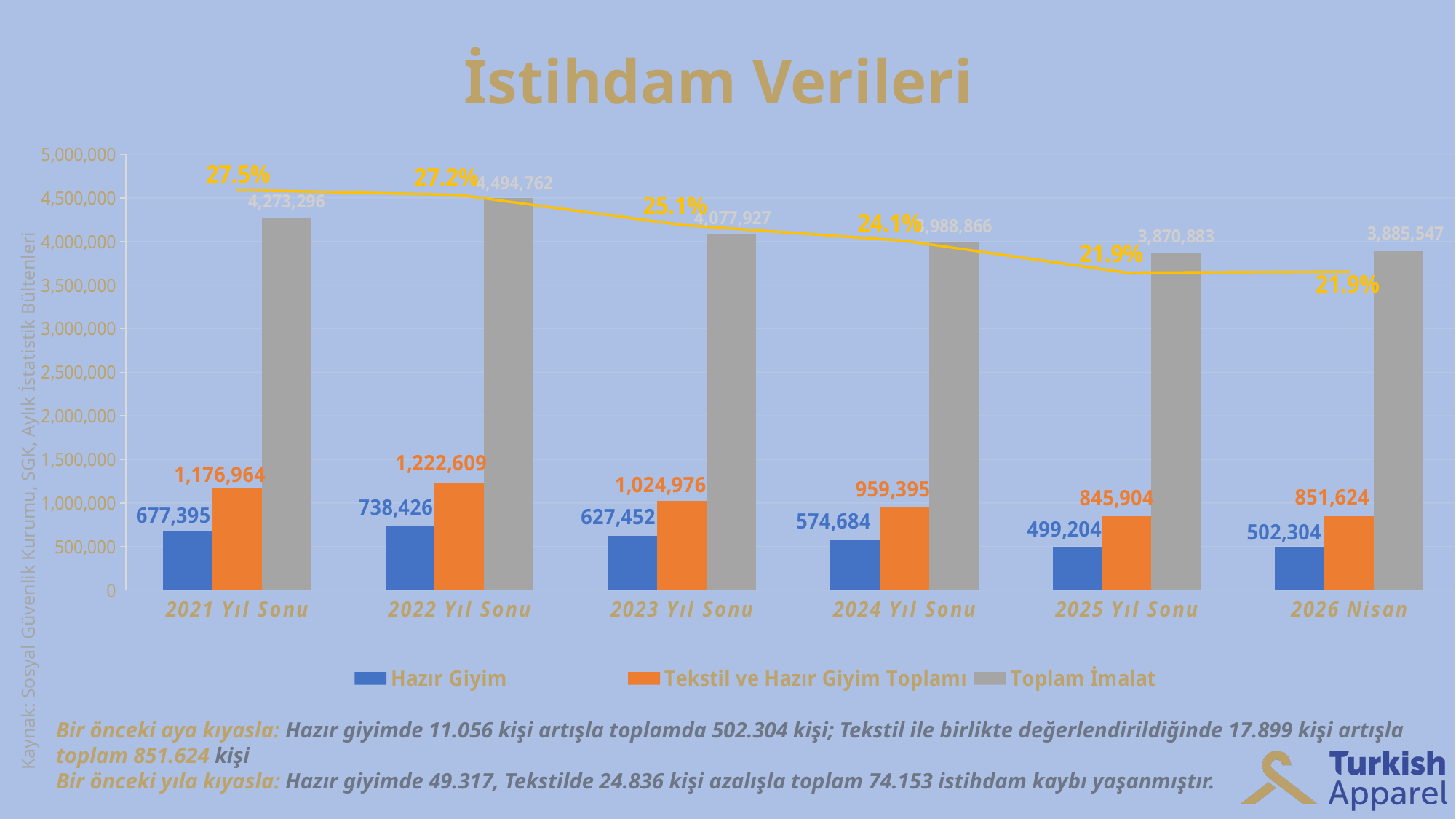
What is the value for Tekstil ve Hazır Giyim Toplamı at 2026 Nisan? 851,624 In which period is Hazır Giyim lowest? 2025 Yıl Sonu Which is larger for Hazır Giyim: 2023 Yıl Sonu or 2024 Yıl Sonu? 2023 Yıl Sonu Is the value for Toplam İmalat at 2025 Yıl Sonu greater or less than 4,000,000? less In which period is Toplam İmalat highest? 2022 Yıl Sonu How many series does the legend list? 3 What kind of chart is this? combination bar and line chart How many periods are shown on the x axis? 6 What is the difference between Tekstil ve Hazır Giyim Toplamı at 2022 Yıl Sonu and at 2021 Yıl Sonu? 45,645 What is the value for Toplam İmalat at 2023 Yıl Sonu? 4,077,927 What is the value for Hazır Giyim at 2022 Yıl Sonu? 738,426 Does Toplam İmalat rise or fall from 2022 Yıl Sonu to 2025 Yıl Sonu? fall